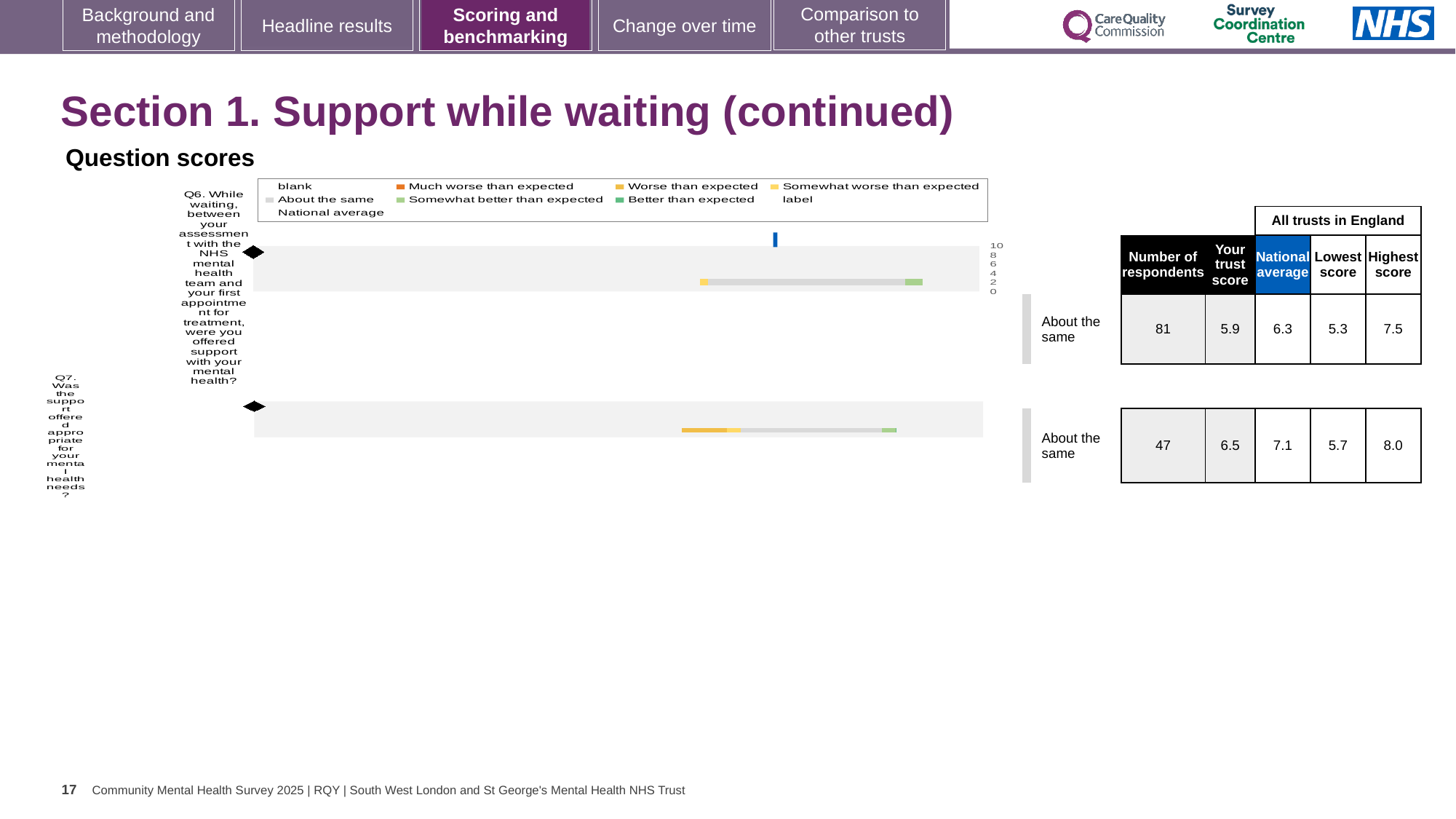
What is the national average for Q7 (was the support offered appropriate)? 7.1 What kind of chart is used to show the question scores on this slide? bar chart What benchmark category is shown for Q7 in the question scores chart? About the same Which question has the higher trust score, Q6 or Q7? Q7 How many entries does the legend of the question scores chart list? 9 What is the difference between the highest and lowest scores for Q7? 2.3 How many respondents answered Q6? 81 What is the difference between the national average and the trust score for Q6? 0.4 What is the trust score for Q6 (support with mental health while waiting)? 5.9 How many questions are plotted in the question scores chart? 2 What is the highest score among all trusts in England for Q7? 8.0 What is the lowest score among all trusts in England for Q6? 5.3